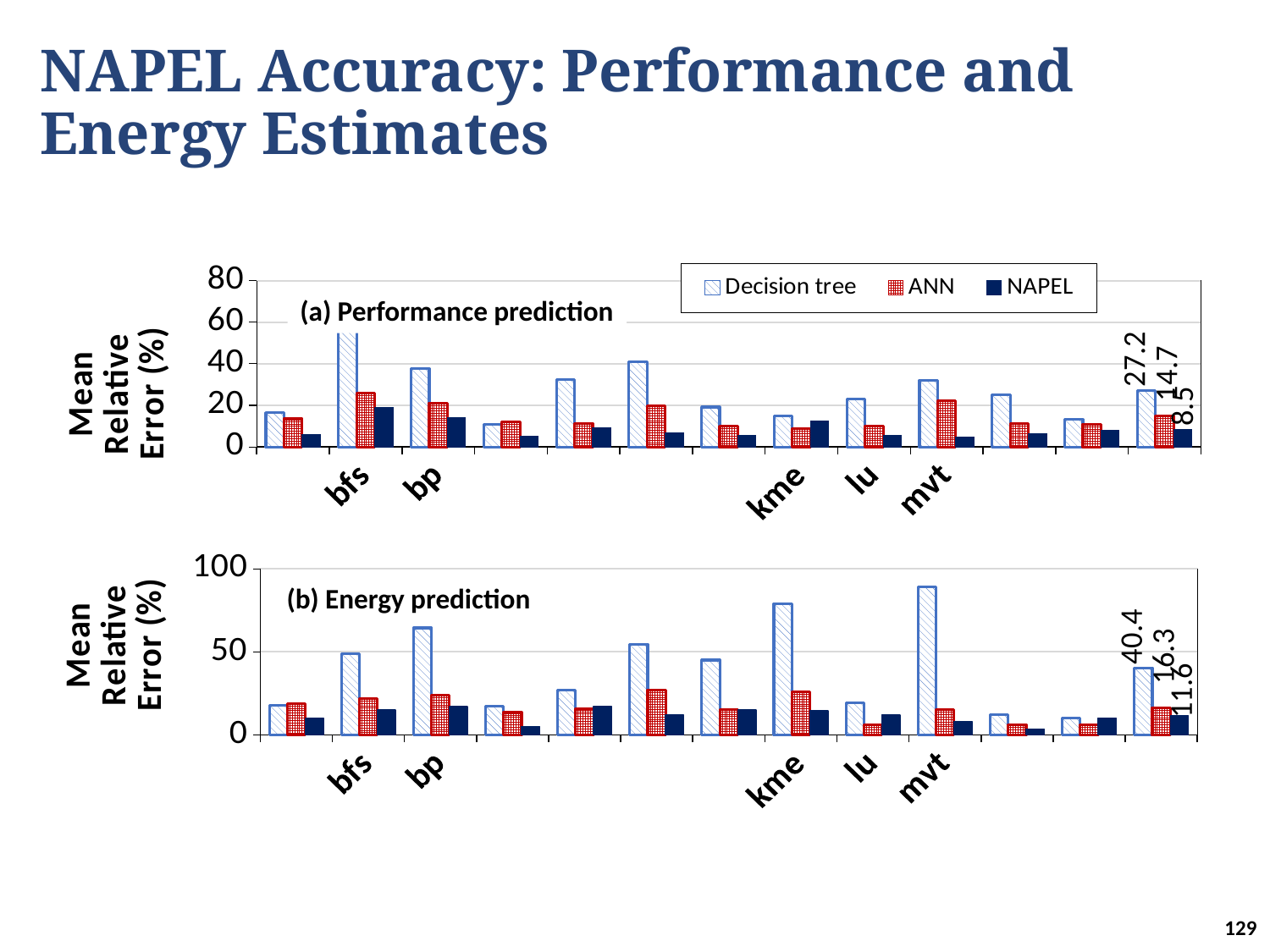
What are the three series named in the legend? Decision tree, ANN, NAPEL In the (b) Energy prediction chart, is the Decision tree value for mvt greater or less than 50? greater In the (b) Energy prediction chart, among the labeled categories bfs, bp, kme, lu and mvt, which has the highest Decision tree value? mvt In the (a) Performance prediction chart, is the Decision tree value for bfs greater or less than 40? greater What is the y-axis label of the (b) Energy prediction chart? Mean Relative Error (%) In the (a) Performance prediction chart, which is larger for bfs: the Decision tree value or the ANN value? Decision tree In the (a) Performance prediction chart, is the Decision tree value for kme greater or less than 20? less How many series does the legend list for the charts on this slide? 3 In the (b) Energy prediction chart, which is larger for bp: the Decision tree value or the NAPEL value? Decision tree What kind of chart is used for (a) Performance prediction? bar chart